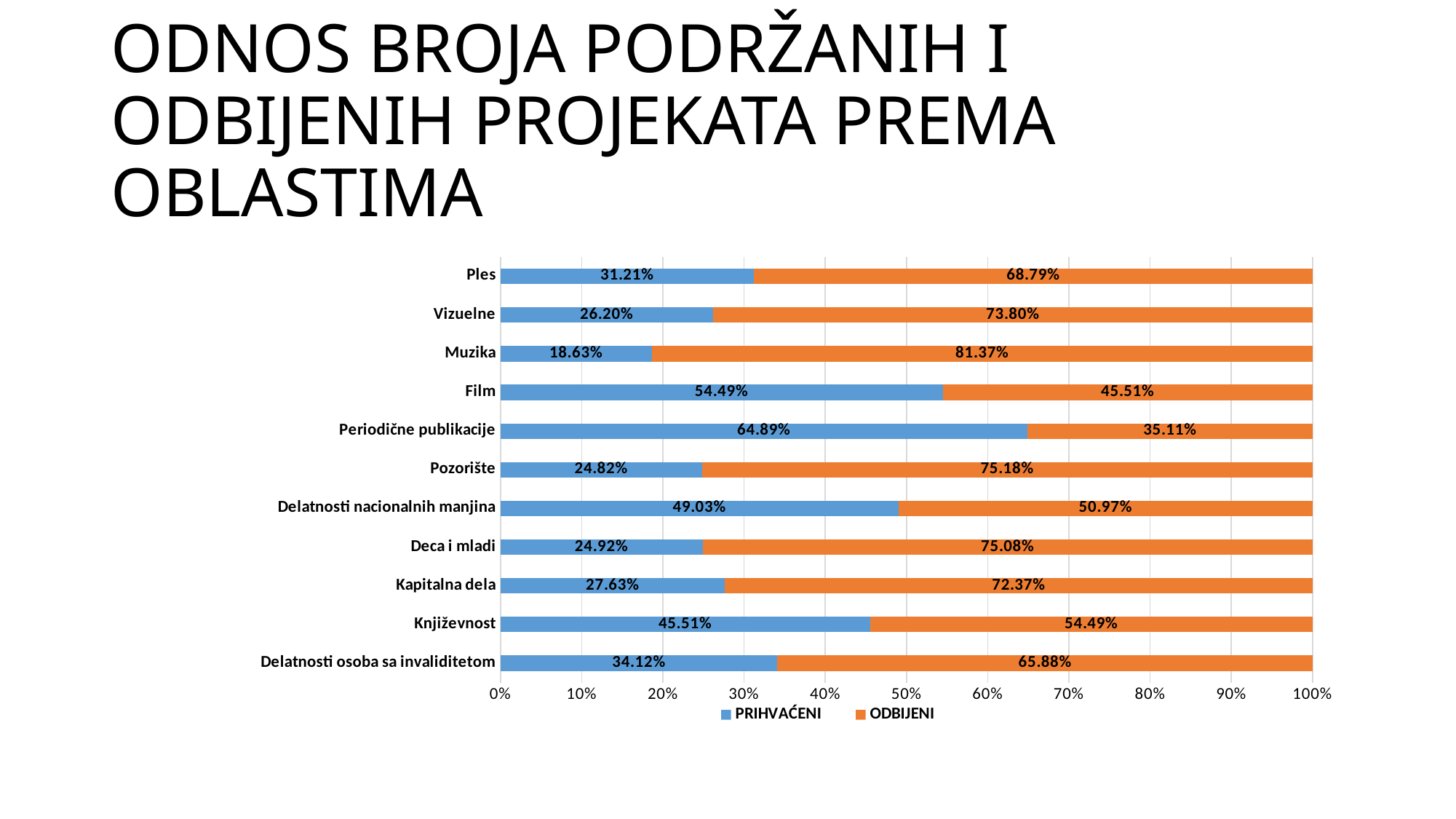
What is the PRIHVAĆENI value for Delatnosti osoba sa invaliditetom? 34.12% What is the ODBIJENI value for Periodične publikacije? 35.11% How many series does the legend list? 2 Which category has the highest ODBIJENI value? Muzika What kind of chart is shown on the slide? Stacked bar chart Which category has the highest PRIHVAĆENI value? Periodične publikacije Which category has the lowest PRIHVAĆENI value? Muzika Which is larger for Film: the PRIHVAĆENI value or the ODBIJENI value? PRIHVAĆENI What is the total of the stacked bar for Knjiżevnost? 100% How many categories are shown on the chart? 11 What is the PRIHVAĆENI value for Muzika? 18.63% What is the difference between the ODBIJENI and PRIHVAĆENI values for Ples? 37.58%